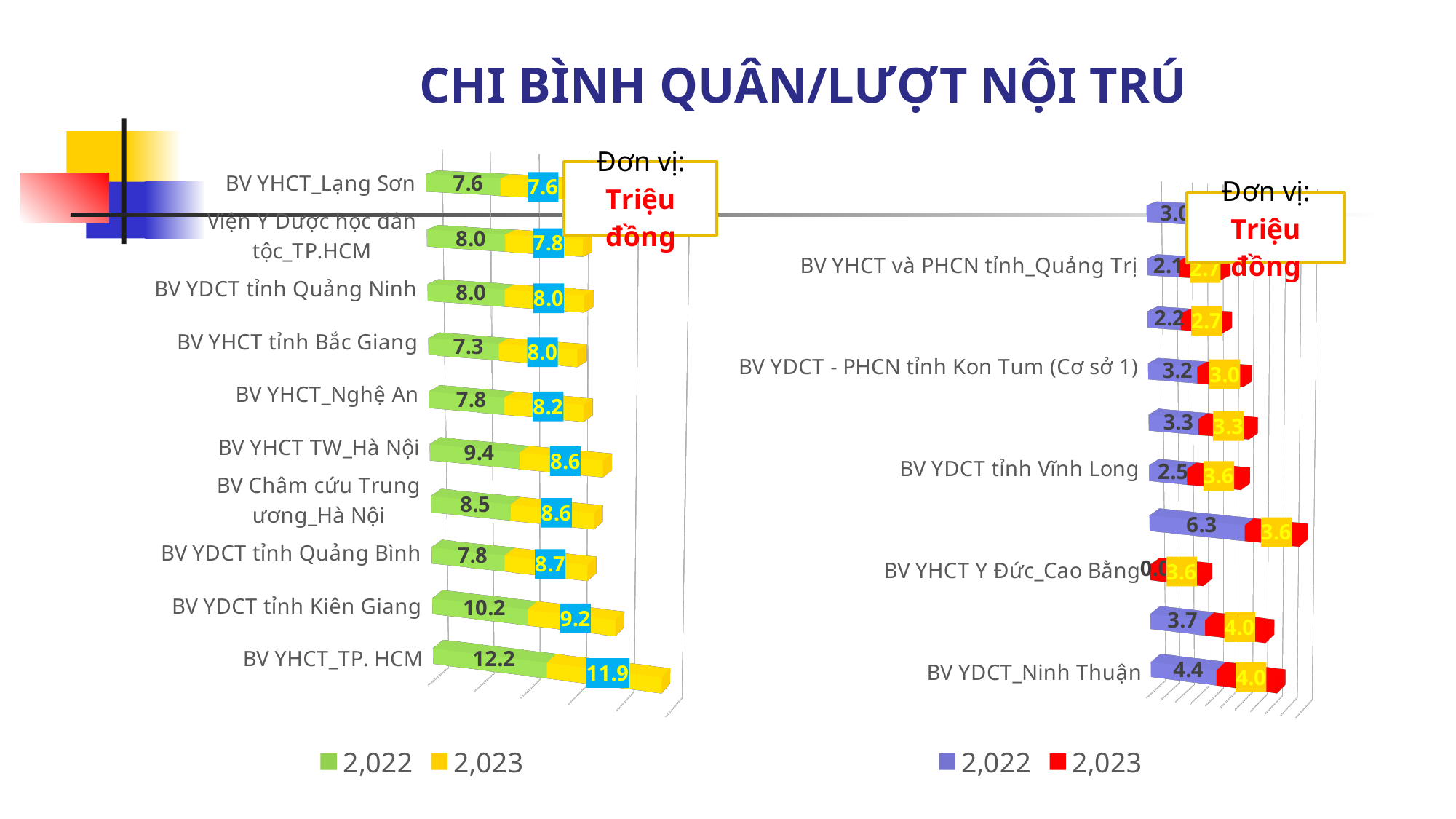
In the left chart, which category has the highest 2,023 value? BV YHCT_TP. HCM In the left chart, what is the 2,022 value for BV YHCT_TP. HCM? 12.2 How many series does the legend of the left chart list? 2 In the right chart, what is the 2,023 value for BV YDCT tỉnh Vĩnh Long? 3.6 In the right chart, what is the difference between the 2,022 and 2,023 values for BV YDCT - PHCN tỉnh Kon Tum (Cơ sở 1)? 0.2 In the left chart, for BV YDCT tỉnh Quảng Bình, which is larger: the 2,022 value or the 2,023 value? 2,023 In the left chart, what is the difference between the 2,022 and 2,023 values for BV YHCT TW_Hà Nội? 0.8 In the left chart, which category has the lowest 2,022 value? BV YHCT tỉnh Bắc Giang In the right chart, what is the 2,022 value for BV YDCT_Ninh Thuận? 4.4 How many categories are shown in the left chart? 10 In the left chart, what is the 2,023 value for BV YDCT tỉnh Kiên Giang? 9.2 What kind of chart is the left chart? bar chart